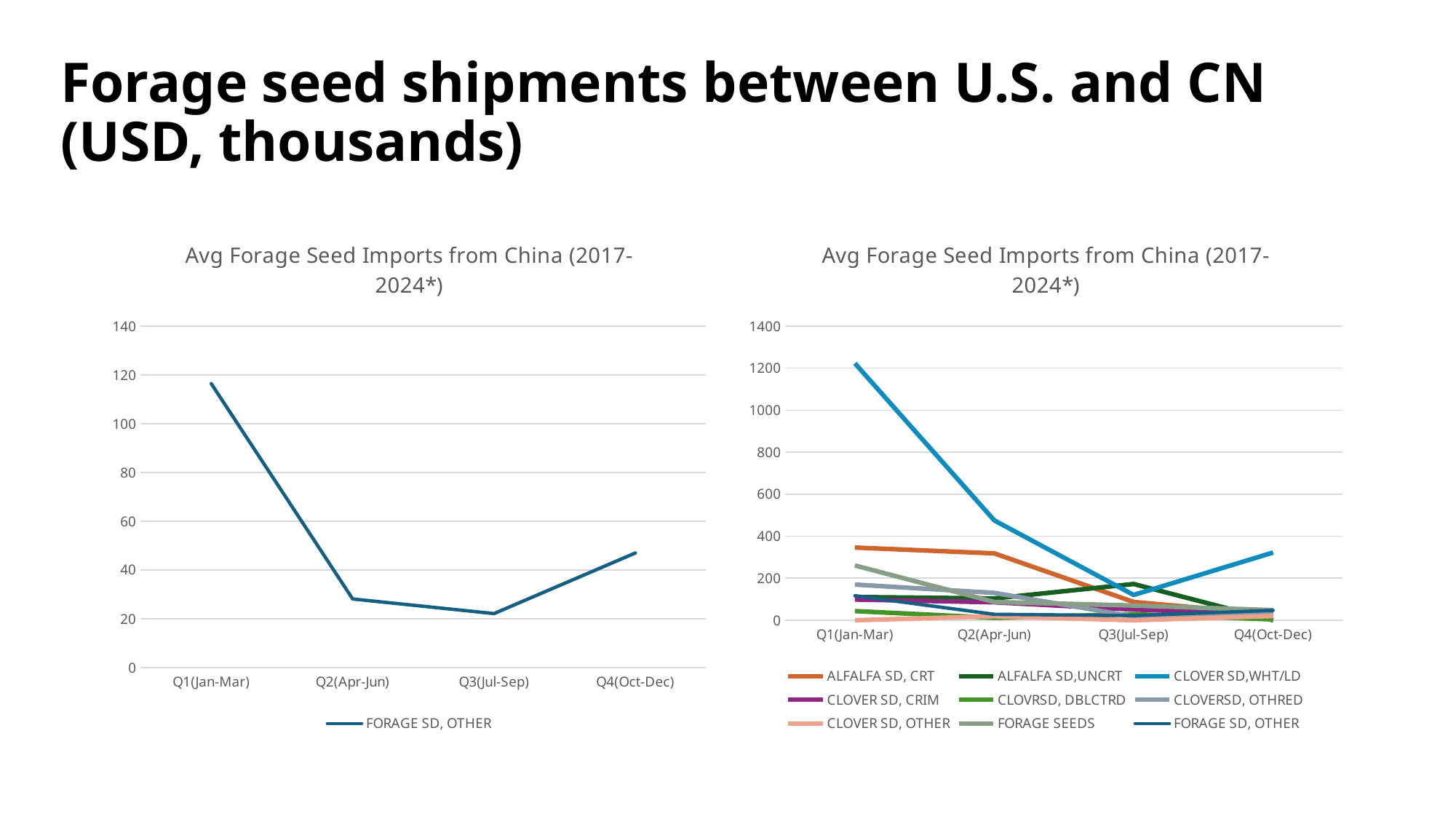
What kind of chart is the left chart on the slide? line chart On the right chart, does the CLOVER SD,WHT/LD line rise or fall from Q1(Jan-Mar) to Q3(Jul-Sep)? fall On the left chart, what is the name of the series shown in the legend? FORAGE SD, OTHER On the right chart, how many series does the legend list? 9 On the right chart, is the value for CLOVER SD,WHT/LD at Q1(Jan-Mar) greater or less than 1000? greater On the left chart, is the value for Q1(Jan-Mar) greater or less than 100? greater On the left chart, which quarter has the highest value for FORAGE SD, OTHER? Q1(Jan-Mar) On the right chart, which series has the highest value at Q1(Jan-Mar)? CLOVER SD,WHT/LD On the left chart, how many quarters are plotted along the x axis? 4 On the left chart, which is larger: the value for Q4(Oct-Dec) or the value for Q2(Apr-Jun)? Q4(Oct-Dec) On the left chart, which quarter has the lowest value for FORAGE SD, OTHER? Q3(Jul-Sep) On the left chart, is the value for Q2(Apr-Jun) greater or less than 40? less